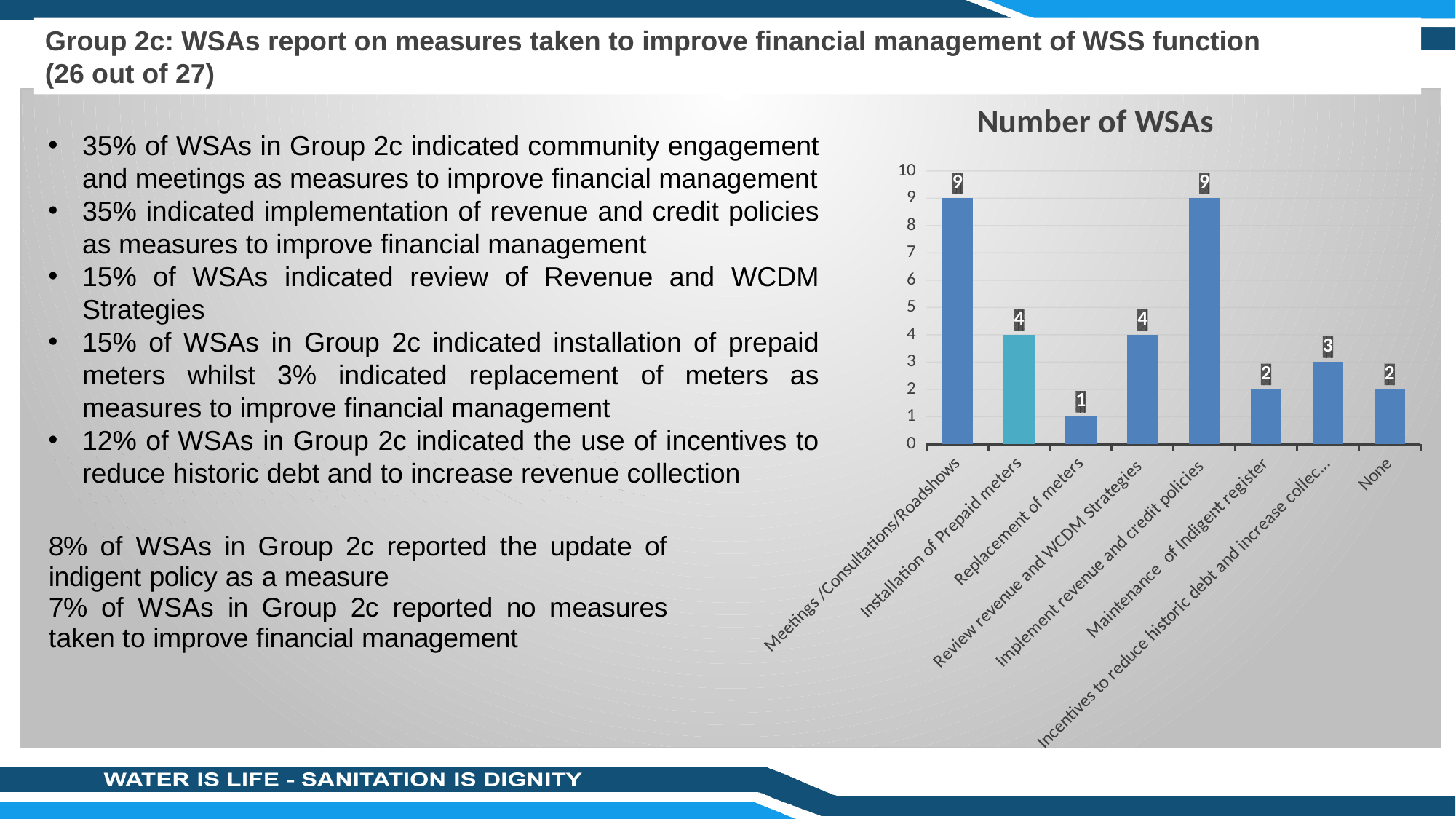
What is the value for Replacement of meters? 1 What is the value for None? 2 What is the value for Implement revenue and credit policies? 9 Which category has the lowest value? Replacement of meters What kind of chart is shown on the slide? Bar chart How many categories are shown on the x axis? 8 What is the value for Installation of Prepaid meters? 4 What is the value for Maintenance of Indigent register? 2 Which is larger, the value for Installation of Prepaid meters or the value for Maintenance of Indigent register? Installation of Prepaid meters What is the difference between the values for Review revenue and WCDM Strategies and None? 2 What is the title of the chart? Number of WSAs What is the difference between the values for Meetings /Consultations/Roadshows and Installation of Prepaid meters? 5